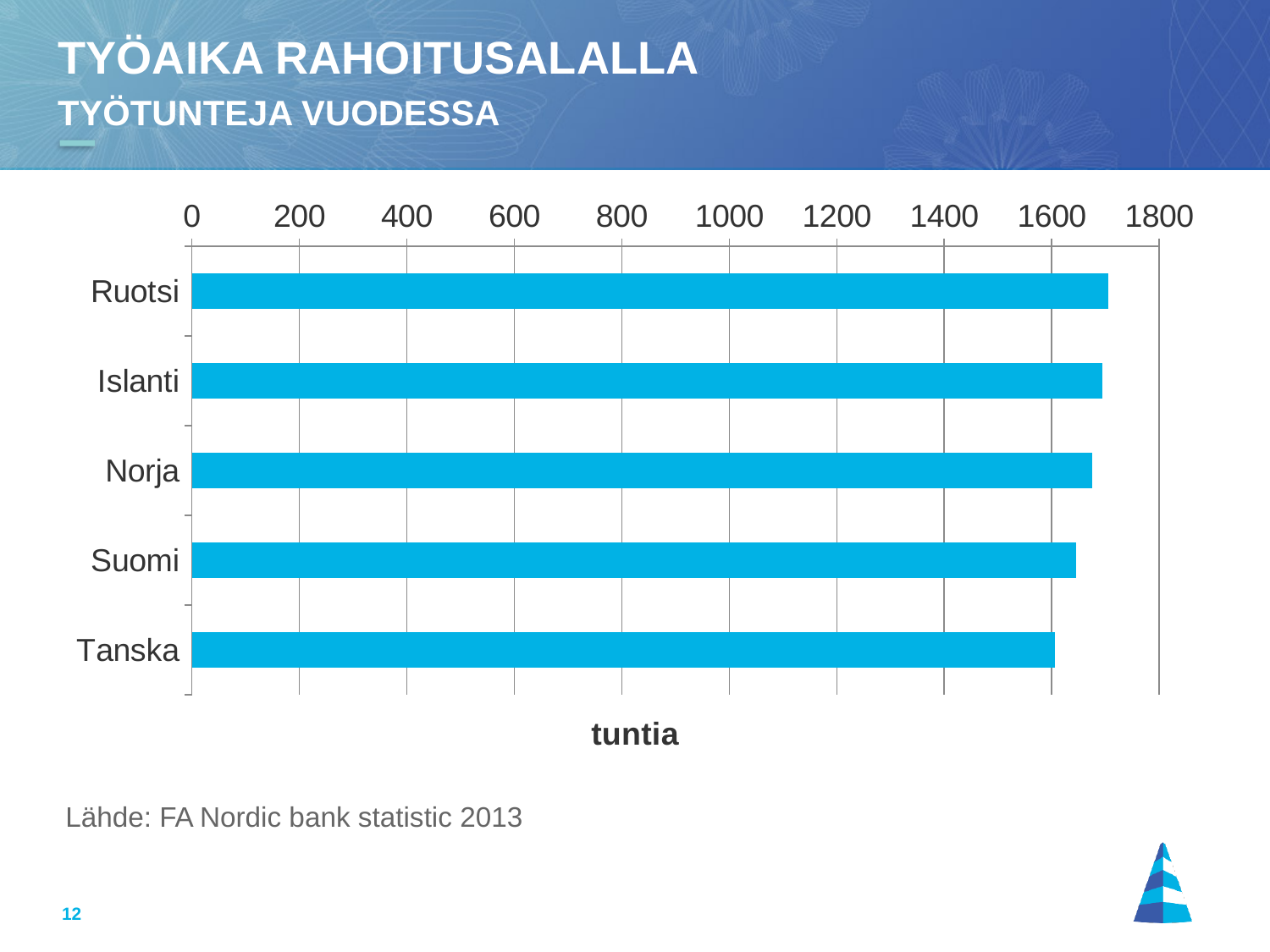
Which has the larger value, Ruotsi or Tanska? Ruotsi Which has the larger value, Norja or Suomi? Norja What is the source cited below the chart? FA Nordic bank statistic 2013 How many countries are shown in the chart? 5 Is the value for Suomi greater or less than 1400? greater Which country has the lowest value in the chart? Tanska Is the value for Islanti greater or less than 1800? less What kind of chart is shown on the slide? bar chart What is the label of the horizontal axis? tuntia Which has the larger value, Suomi or Tanska? Suomi Is the value for Tanska greater or less than 1800? less